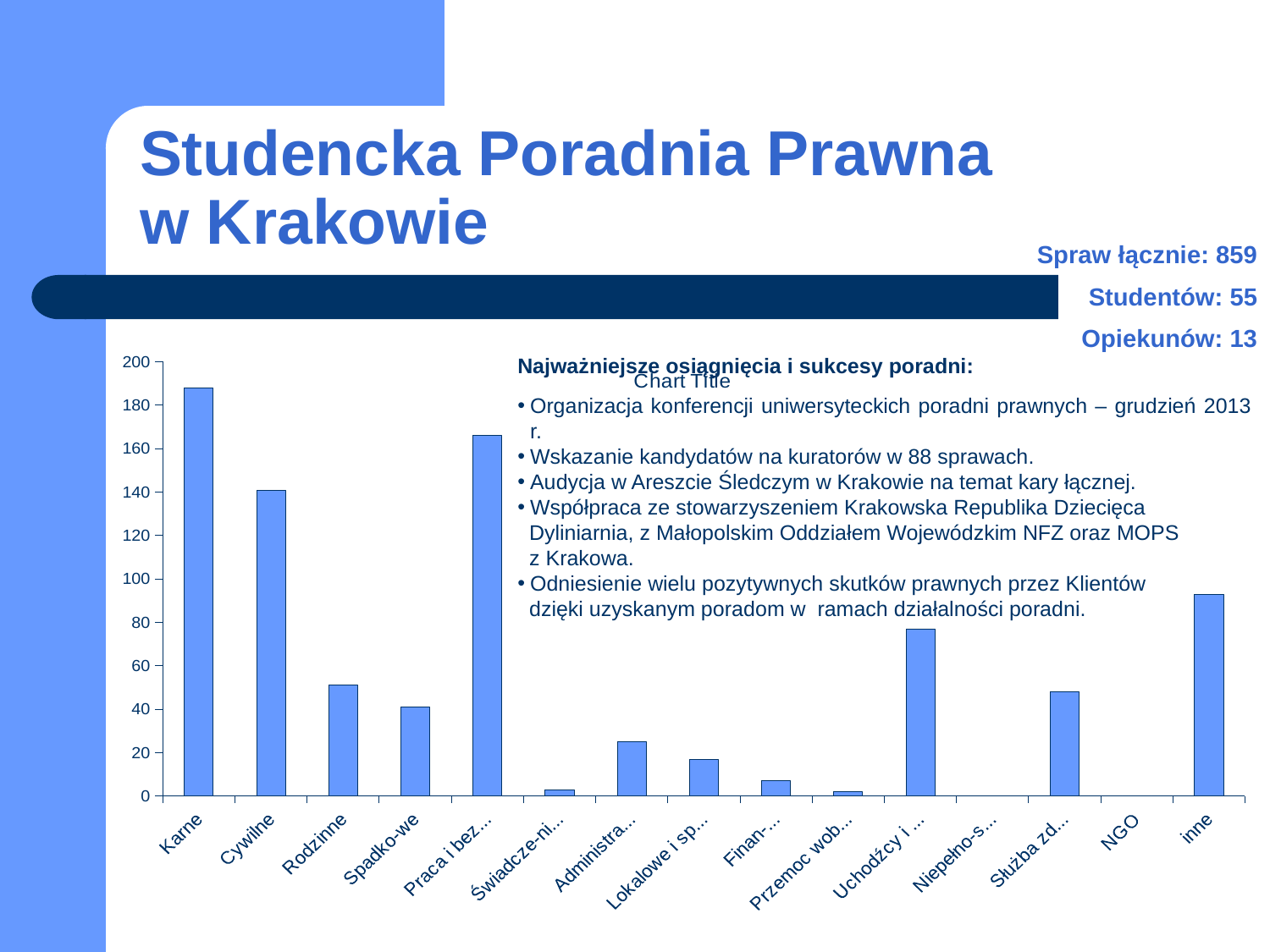
What kind of chart is shown on the slide? bar chart Is the value for Praca i bez... greater or less than 140? greater Which category has the highest value in the chart? Karne Is the value for Uchodźcy i ... greater or less than 60? greater Is the value for Rodzinne greater or less than 60? less What is the title shown on the chart? Chart Title Which has the larger value, Karne or Cywilne? Karne Which has the larger value, inne or Uchodźcy i ...? inne How many categories are shown on the x axis of the chart? 15